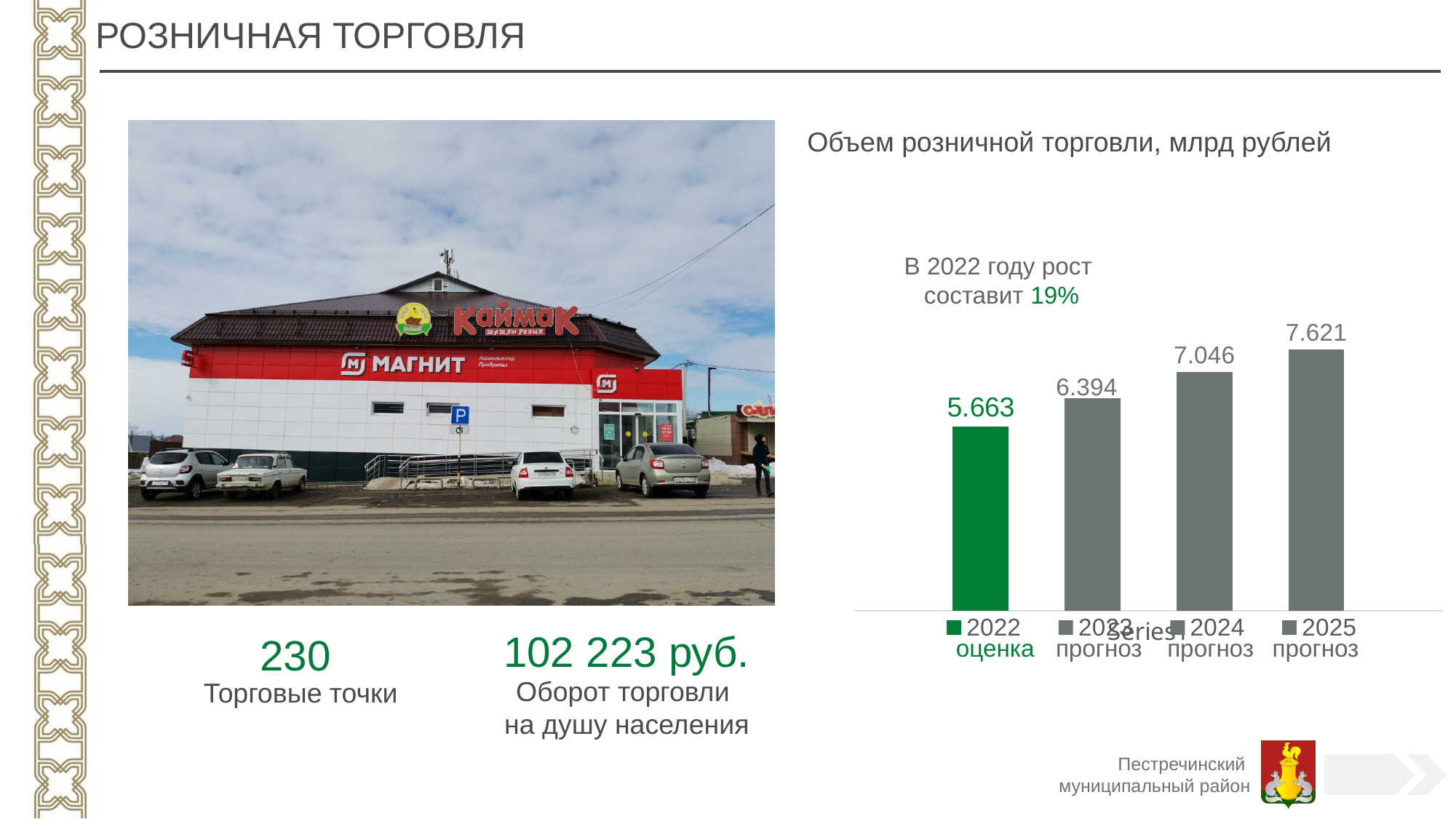
What type of chart is 'Объем розничной торговли, млрд рублей'? bar chart What is the value for 2023 прогноз in the chart 'Объем розничной торговли, млрд рублей'? 6.394 Do the values in the chart 'Объем розничной торговли, млрд рублей' rise or fall from 2022 to 2025? rise What is the value for 2025 прогноз in the chart 'Объем розничной торговли, млрд рублей'? 7.621 What is the difference between the 2023 прогноз and 2022 оценка values in the chart 'Объем розничной торговли, млрд рублей'? 0.731 What is the value for 2022 оценка in the chart 'Объем розничной торговли, млрд рублей'? 5.663 What is the difference between the 2025 прогноз and 2022 оценка values in the chart 'Объем розничной торговли, млрд рублей'? 1.958 Which year has the lowest value in the chart 'Объем розничной торговли, млрд рублей'? 2022 оценка What is the value for 2024 прогноз in the chart 'Объем розничной торговли, млрд рублей'? 7.046 In the chart 'Объем розничной торговли, млрд рублей', which is larger: the value for 2024 прогноз or 2023 прогноз? 2024 прогноз How many bars are shown in the chart 'Объем розничной торговли, млрд рублей'? 4 Which year has the highest value in the chart 'Объем розничной торговли, млрд рублей'? 2025 прогноз